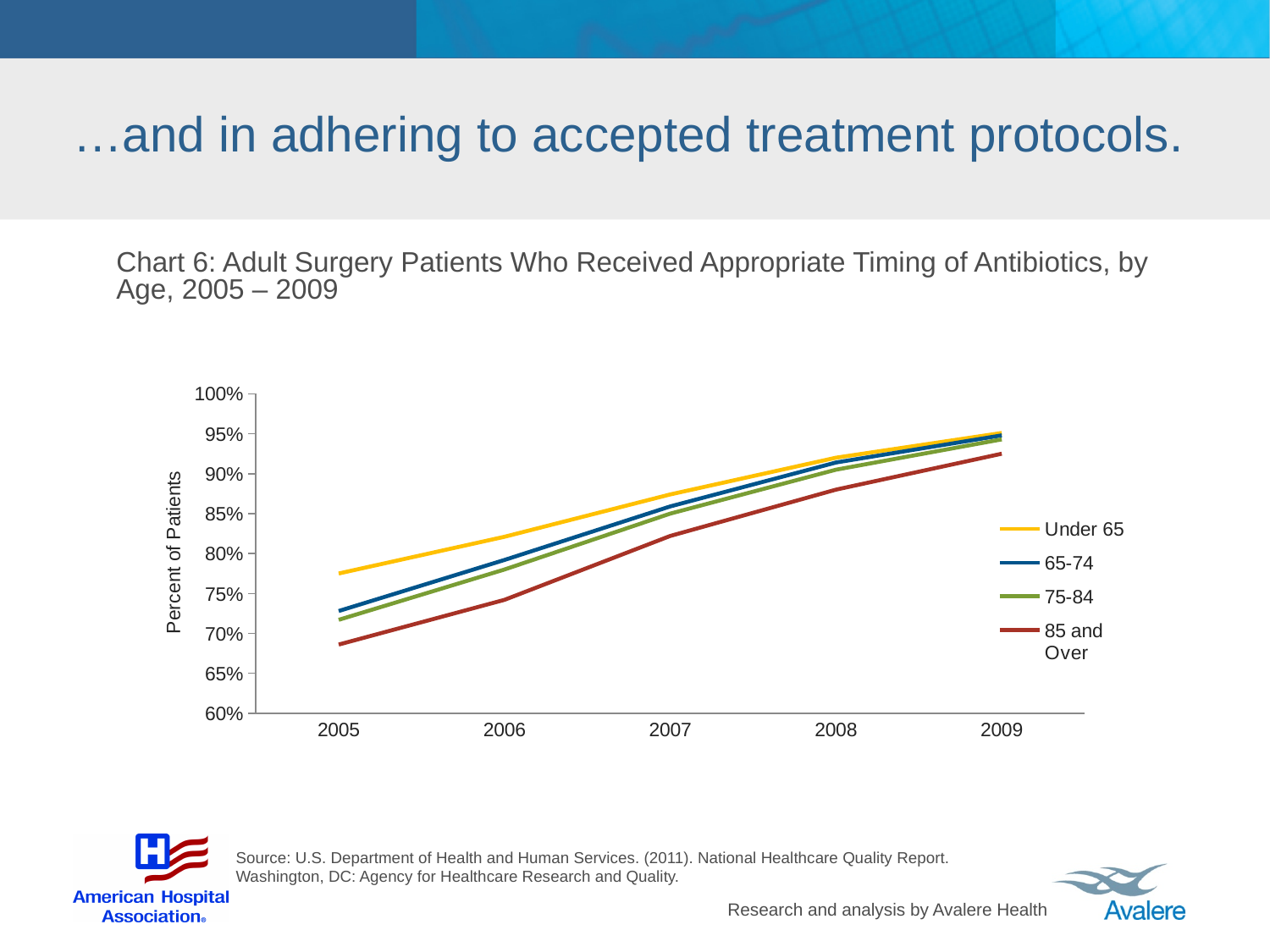
Which age group had the lowest percentage of patients in 2005? 85 and Over Is the value for 85 and Over in 2005 greater or less than 70%? less Is the value for Under 65 in 2005 greater or less than 75%? greater How many years are plotted along the x axis? 5 Is the value for 85 and Over in 2009 greater or less than 90%? greater What is the label on the y axis? Percent of Patients In 2005, which is larger: the value for Under 65 or the value for 85 and Over? Under 65 Which age group had the highest percentage of patients in 2005? Under 65 How many series does the legend list? 4 Do the values for the 65-74 group rise or fall from 2005 to 2009? rise What kind of chart is shown on the slide? line chart